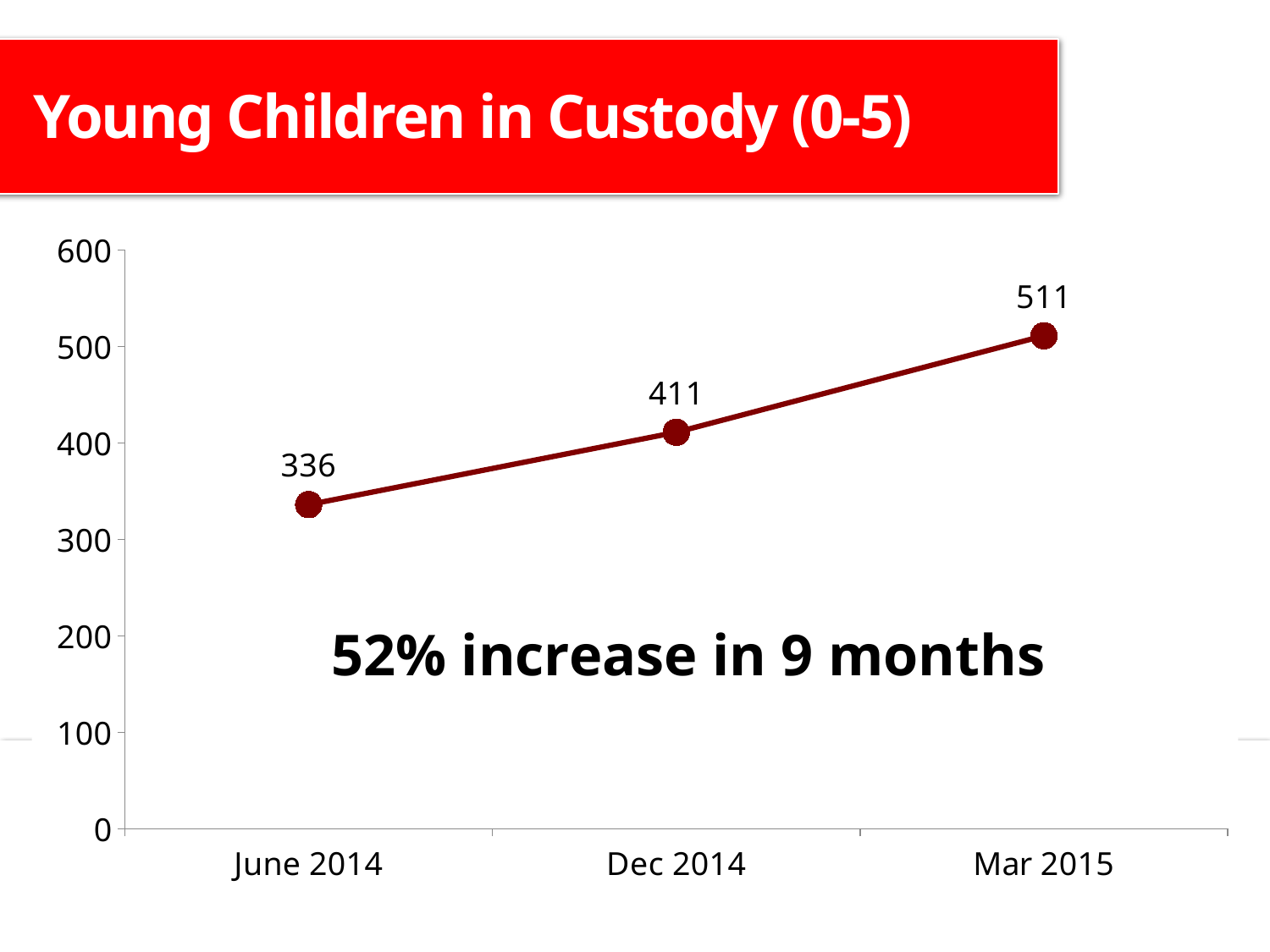
What is the value for Dec 2014? 411 Which point has the highest value? Mar 2015 Is the value for Dec 2014 greater or less than 400? greater Do the values rise or fall from June 2014 to Mar 2015? rise Which point has the lowest value? June 2014 What is the difference between the values for Dec 2014 and June 2014? 75 What kind of chart is shown on the slide? line chart Which is larger, the value for Dec 2014 or the value for Mar 2015? Mar 2015 What is the value for June 2014? 336 What is the value for Mar 2015? 511 What is the difference between the values for Mar 2015 and June 2014? 175 How many data points are plotted on the chart? 3